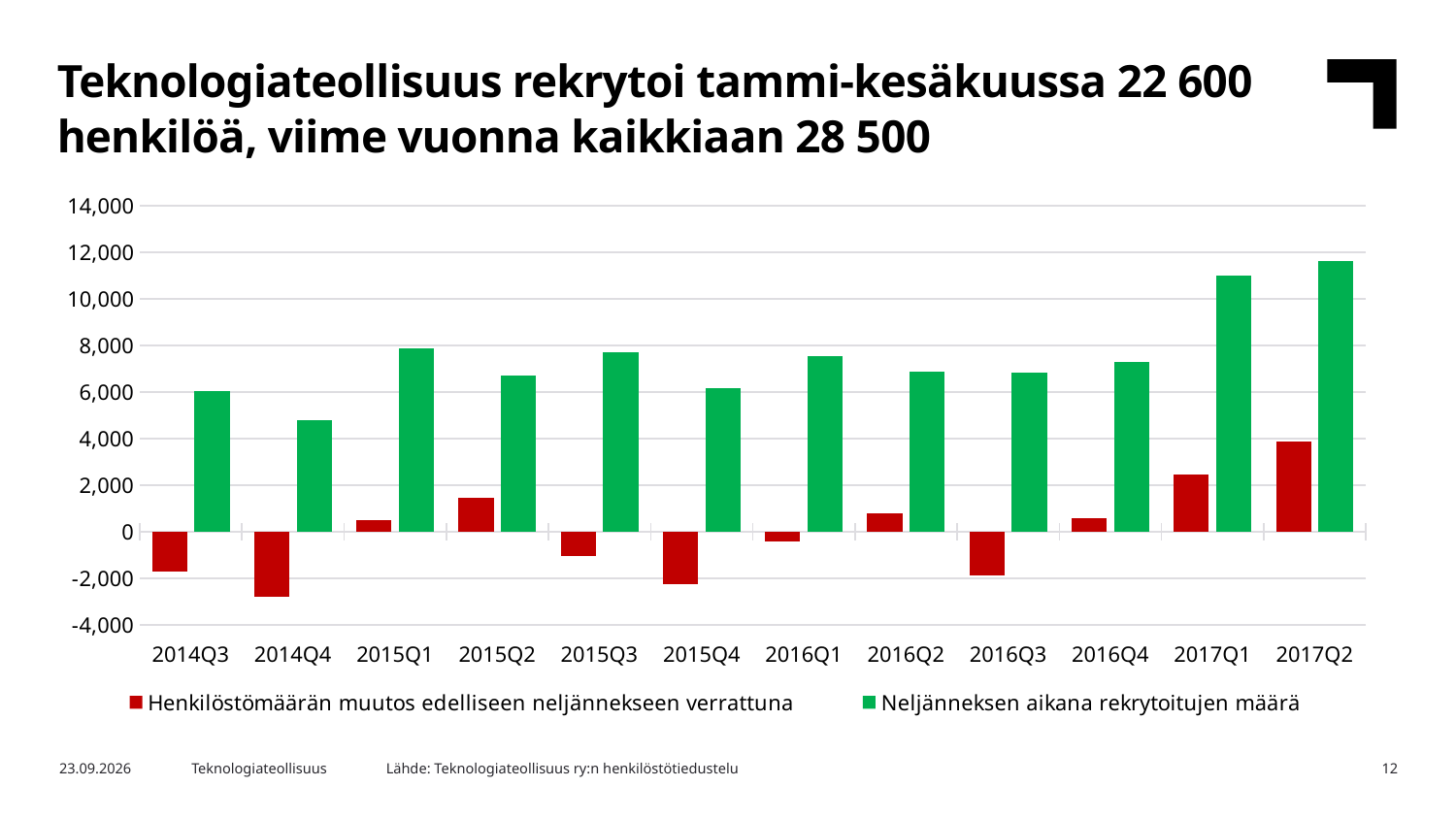
How many quarters are shown on the x axis of the chart? 12 What kind of chart is shown on the slide? bar chart Which quarter has the highest value for 'Neljänneksen aikana rekrytoitujen määrä'? 2017Q2 Which quarter has the highest value for 'Henkilöstömäärän muutos edelliseen neljännekseen verrattuna'? 2017Q2 Which quarter has the lowest value for 'Neljänneksen aikana rekrytoitujen määrä'? 2014Q4 Which quarter has the lowest value for 'Henkilöstömäärän muutos edelliseen neljännekseen verrattuna'? 2014Q4 Is the value for 'Neljänneksen aikana rekrytoitujen määrä' in 2017Q1 greater or less than 10,000? greater Is the value for 'Neljänneksen aikana rekrytoitujen määrä' in 2014Q4 greater or less than 6,000? less From 2016Q4 to 2017Q2, does the value for 'Neljänneksen aikana rekrytoitujen määrä' rise or fall? rise Is the value for 'Henkilöstömäärän muutos edelliseen neljännekseen verrattuna' in 2017Q1 greater or less than 2,000? greater Which is larger, the 'Neljänneksen aikana rekrytoitujen määrä' value for 2015Q1 or for 2014Q4? 2015Q1 How many series does the chart's legend list? 2